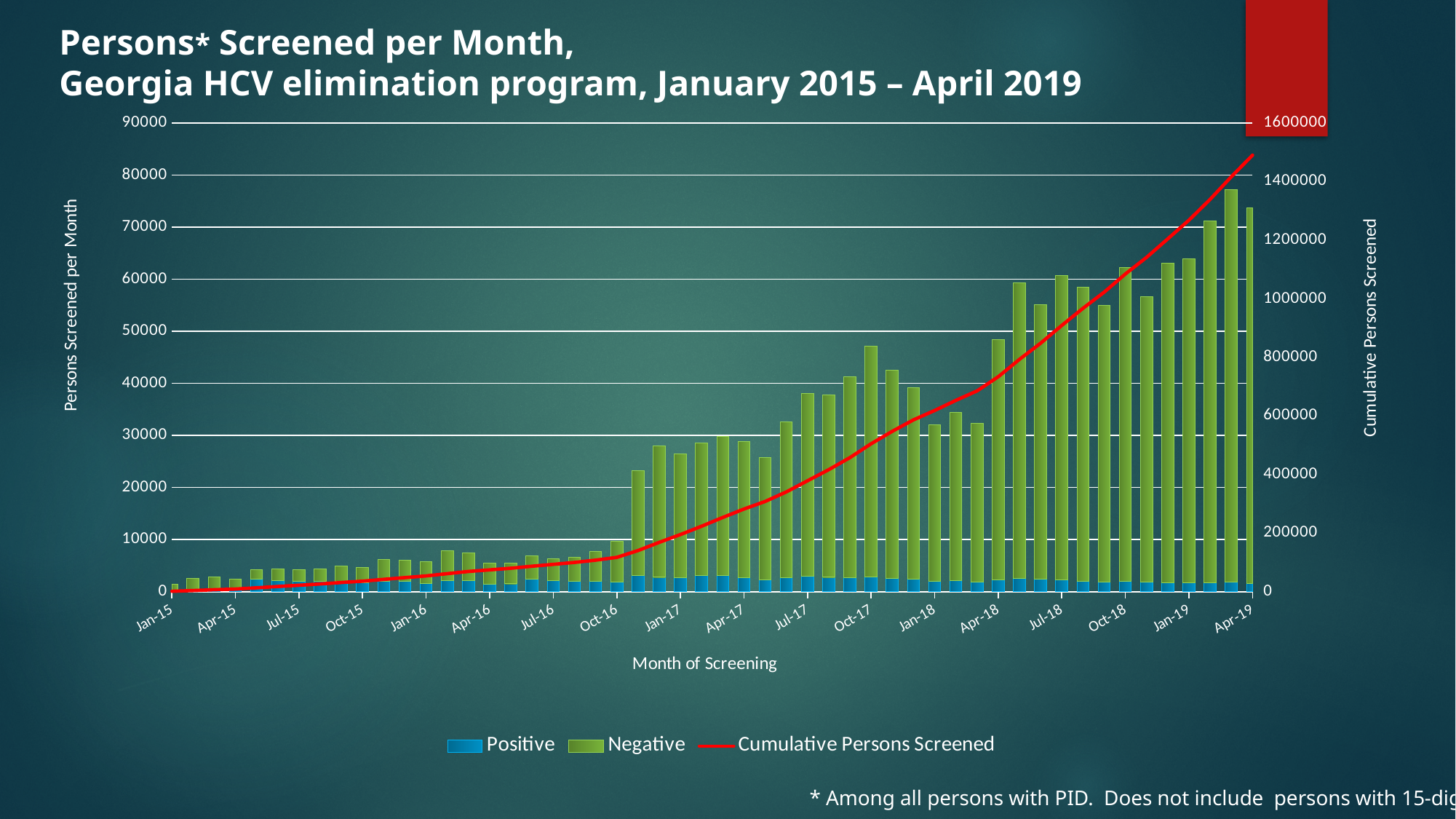
Is the total persons screened in Jul-17 greater or less than 30000? greater Which labeled month has a larger total bar, Jan-19 or Apr-19? Apr-19 What is the title of the x axis? Month of Screening How many series does the legend list? 3 What kind of chart is this? Stacked bar chart with a line Which labeled month has a larger total bar, Jan-17 or Jul-17? Jul-17 Does the Cumulative Persons Screened line rise or fall from Jan-15 to Apr-19? Rises Is the total persons screened in Jan-17 greater or less than 20000? greater Is the total persons screened in Jan-15 greater or less than 10000? less